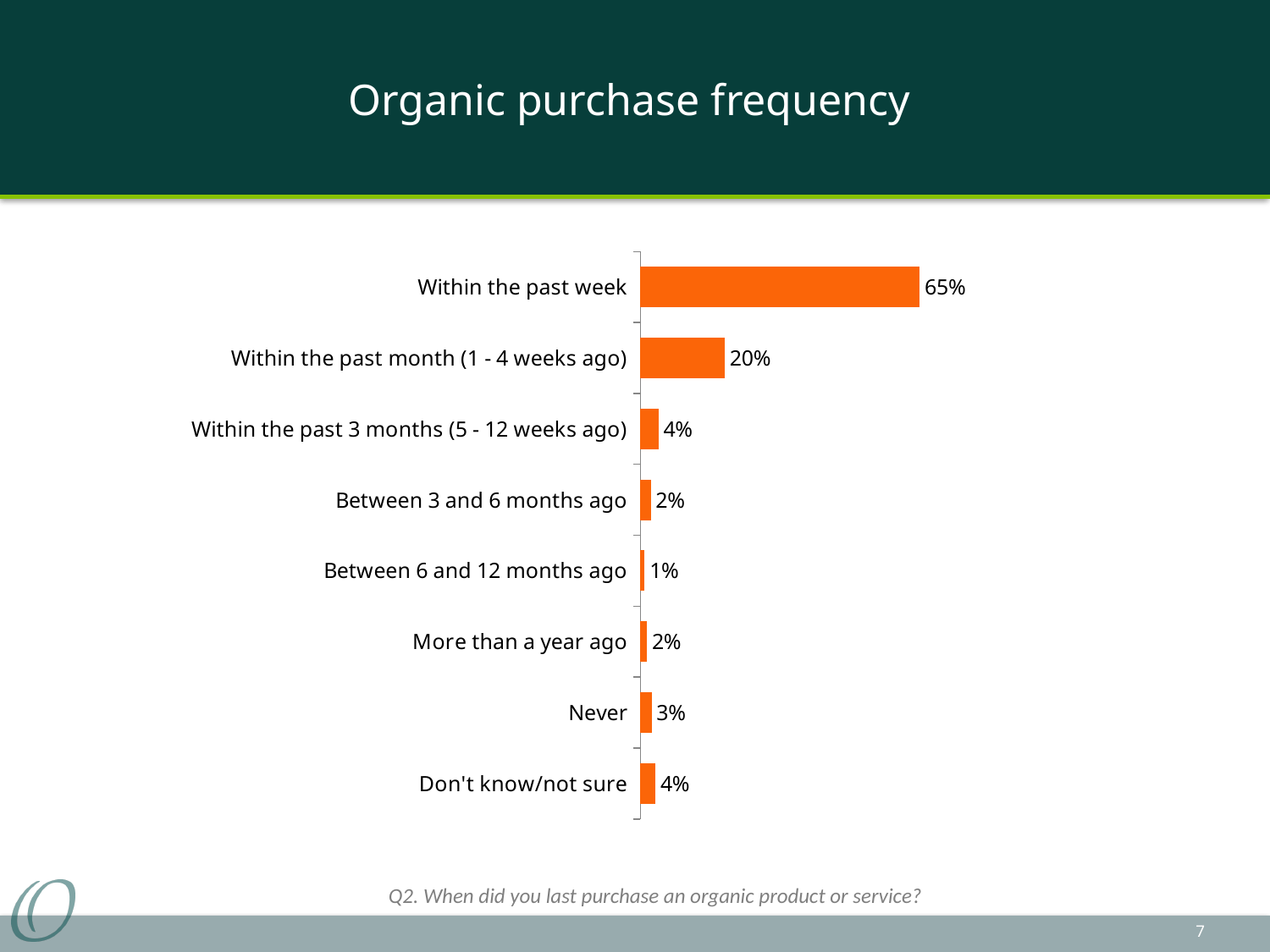
What is the title of the slide? Organic purchase frequency Which category has the lowest value? Between 6 and 12 months ago What is the value for 'Never'? 3% What kind of chart is shown on the slide? Bar chart What is the value for 'Between 6 and 12 months ago'? 1% What survey question is the chart based on, as shown at the bottom of the slide? Q2. When did you last purchase an organic product or service? How many categories are shown in the chart? 8 What is the value for 'Within the past month (1 - 4 weeks ago)'? 20% What is the difference between the values for 'Within the past week' and 'Within the past month (1 - 4 weeks ago)'? 45% What percentage of respondents last purchased an organic product or service within the past week? 65% Which is larger: the value for 'Never' or the value for 'Don't know/not sure'? Don't know/not sure Which category has the highest value? Within the past week